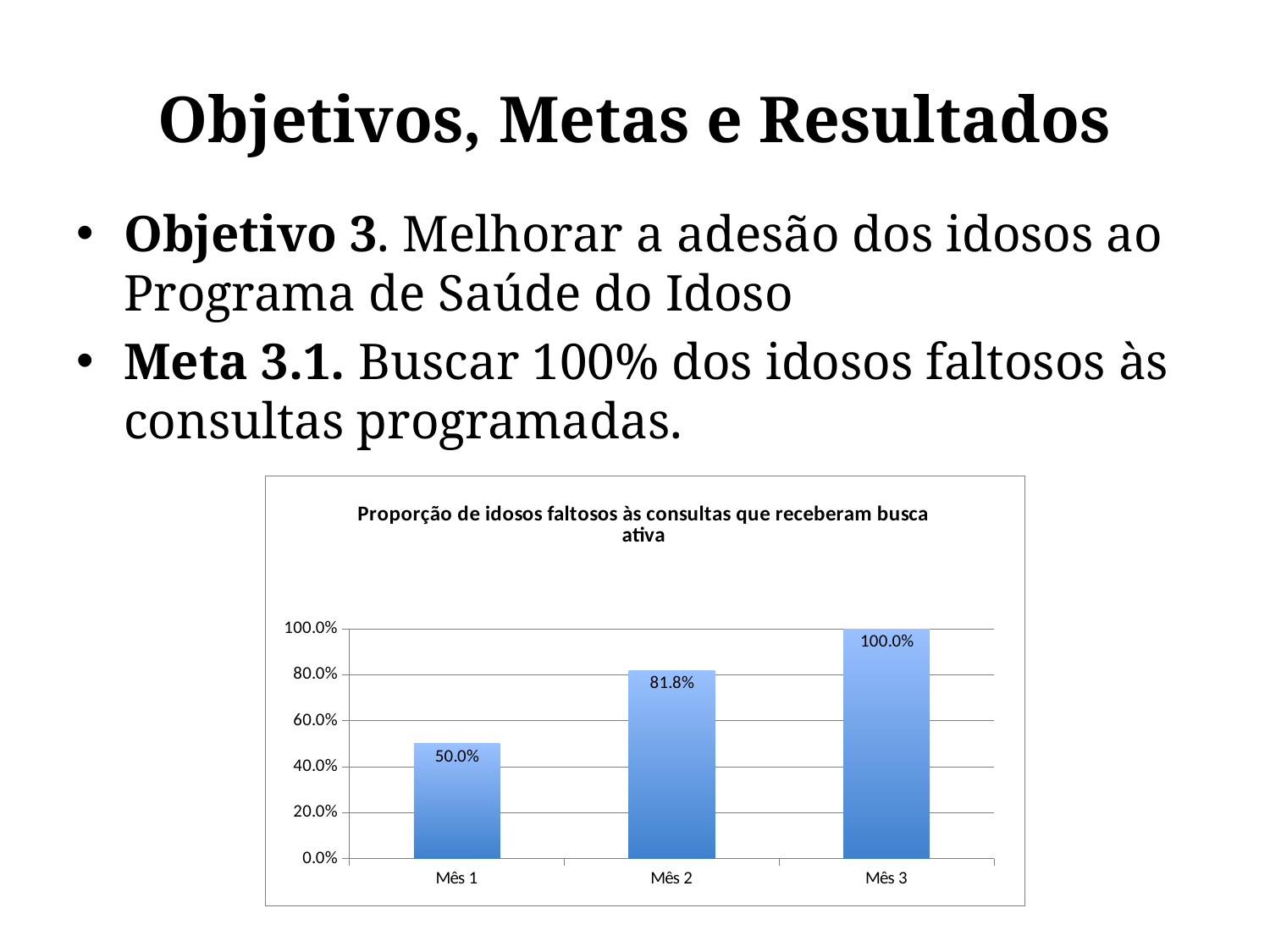
What is the title of the chart? Proporção de idosos faltosos às consultas que receberam busca ativa Which month has the lowest value? Mês 1 What is the difference between the values for Mês 2 and Mês 1? 31.8% How many months are shown on the x axis? 3 Which month has the highest value? Mês 3 What is the value for Mês 1? 50.0% What kind of chart is shown on the slide? Bar chart Which is larger, the value for Mês 2 or the value for Mês 1? Mês 2 Do the values rise or fall from Mês 1 to Mês 3? Rise What is the value for Mês 2? 81.8% What is the value for Mês 3? 100.0% What is the difference between the values for Mês 3 and Mês 1? 50.0%